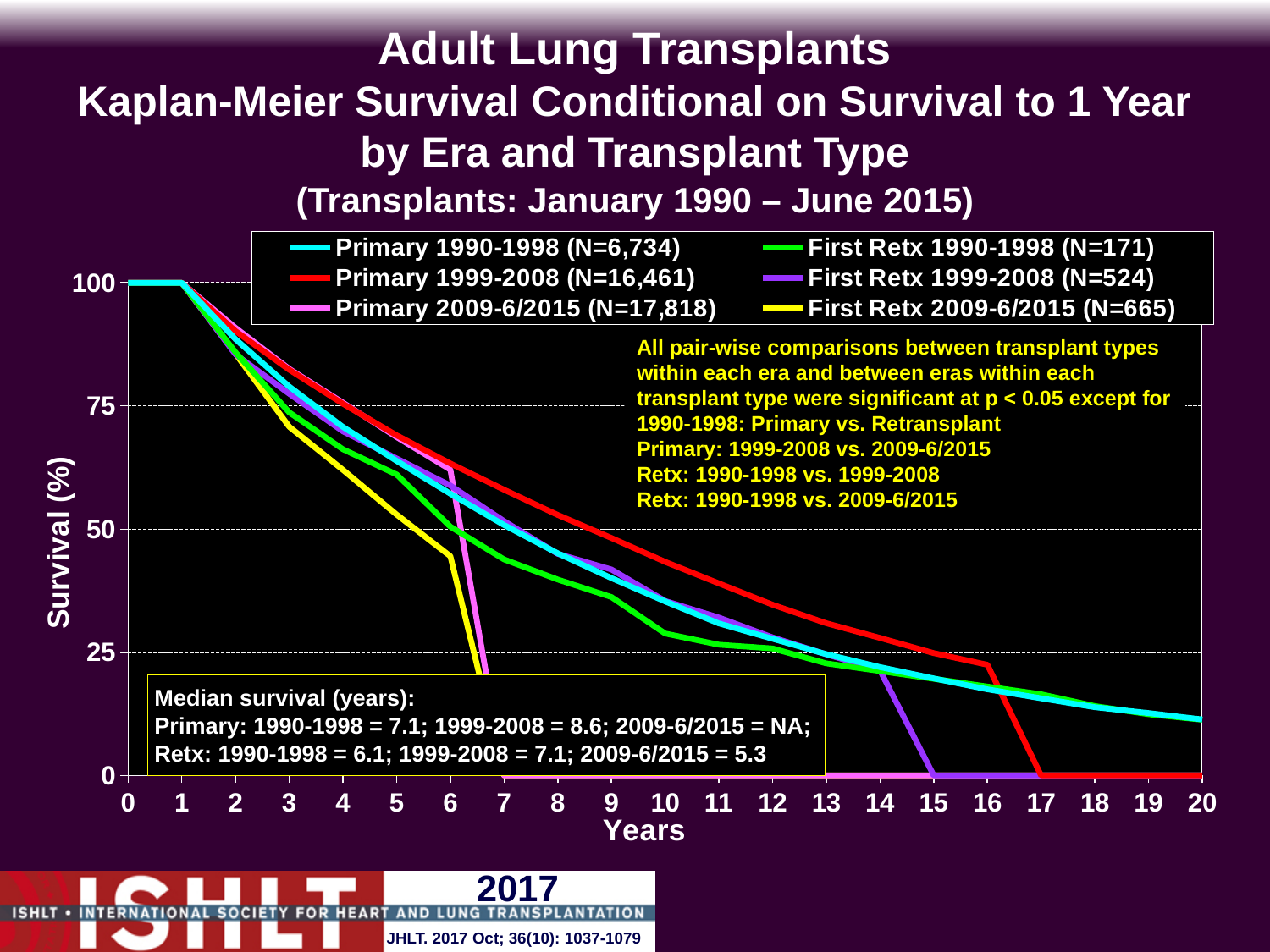
Which series has the smallest N in the legend? First Retx 1990-1998 (N=171) What is the median survival in years for Primary 1999-2008 according to the text box? 8.6 What type of chart is shown on the slide? Line chart How many series does the legend list? 6 Which series has the largest N in the legend? Primary 2009-6/2015 (N=17,818) At 10 years, which series has higher survival: Primary 1999-2008 or Primary 1990-1998? Primary 1999-2008 At 10 years, is the survival for Primary 1999-2008 greater or less than 50? less Do the survival curves rise or fall as years increase? Fall What is the difference in median survival (years) between Primary 1999-2008 and Retx 1999-2008? 1.5 What is the label of the x-axis? Years What is the N for the Primary 1999-2008 series in the legend? 16,461 What is the label of the y-axis? Survival (%)